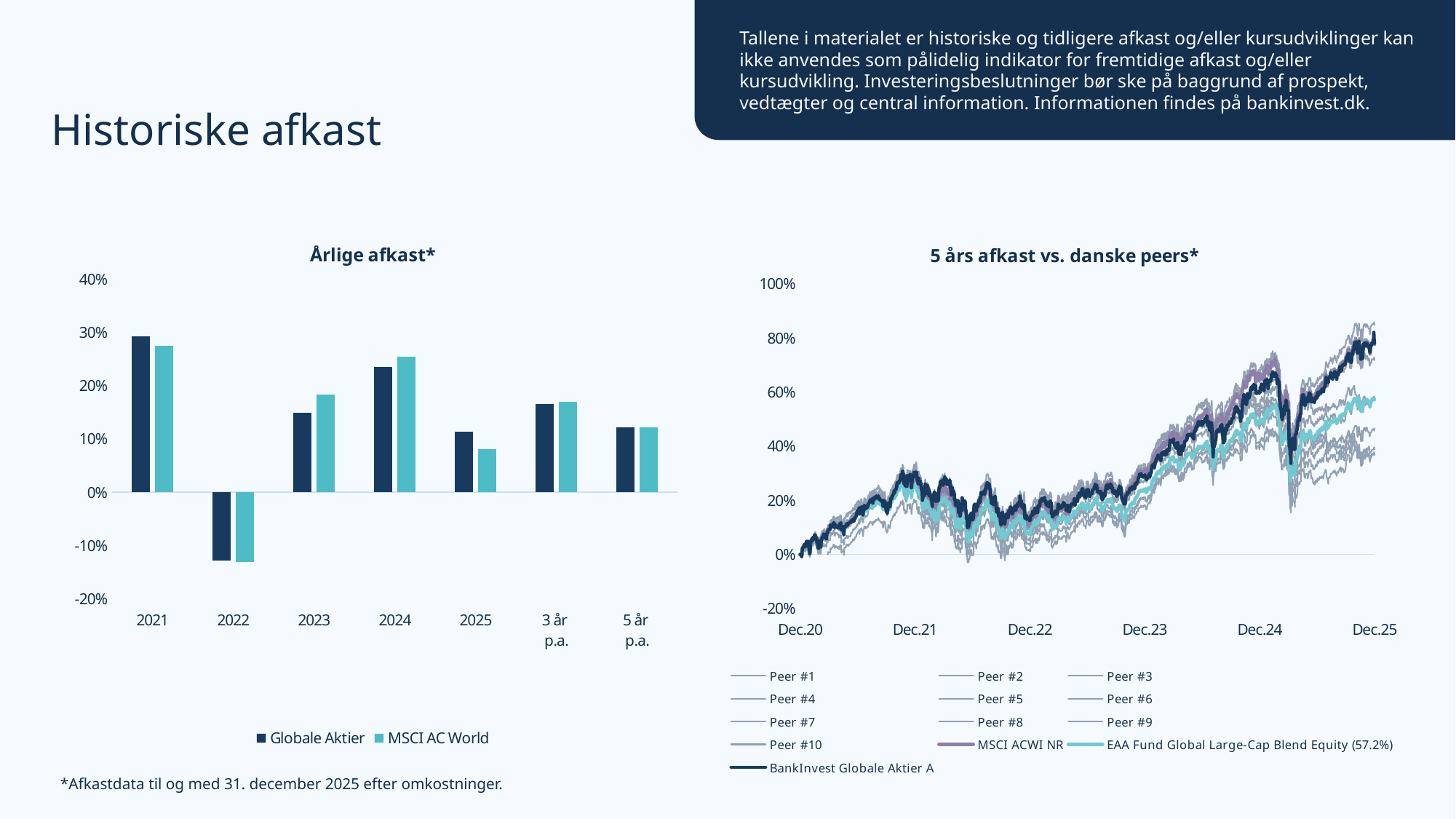
In the 'Årlige afkast*' chart, which year has the highest Globale Aktier bar? 2021 In the 'Årlige afkast*' chart, is the Globale Aktier value for 2021 greater or less than 20%? greater How many categories are shown on the x axis of the 'Årlige afkast*' chart? 7 In the 'Årlige afkast*' chart, which category has the lowest MSCI AC World value? 2022 What kind of chart is the '5 års afkast vs. danske peers*' chart on the right? line chart In the 'Årlige afkast*' chart, is the Globale Aktier value for 2022 greater or less than -10%? less In the '5 års afkast vs. danske peers*' chart, is the BankInvest Globale Aktier A value at Dec.25 greater or less than 60%? greater In the 'Årlige afkast*' chart, which series has the larger value for 2025, Globale Aktier or MSCI AC World? Globale Aktier What kind of chart is the 'Årlige afkast*' chart on the left? bar chart How many series does the legend of the 'Årlige afkast*' chart list? 2 In the 'Årlige afkast*' chart, which series has the larger value for 2023, Globale Aktier or MSCI AC World? MSCI AC World